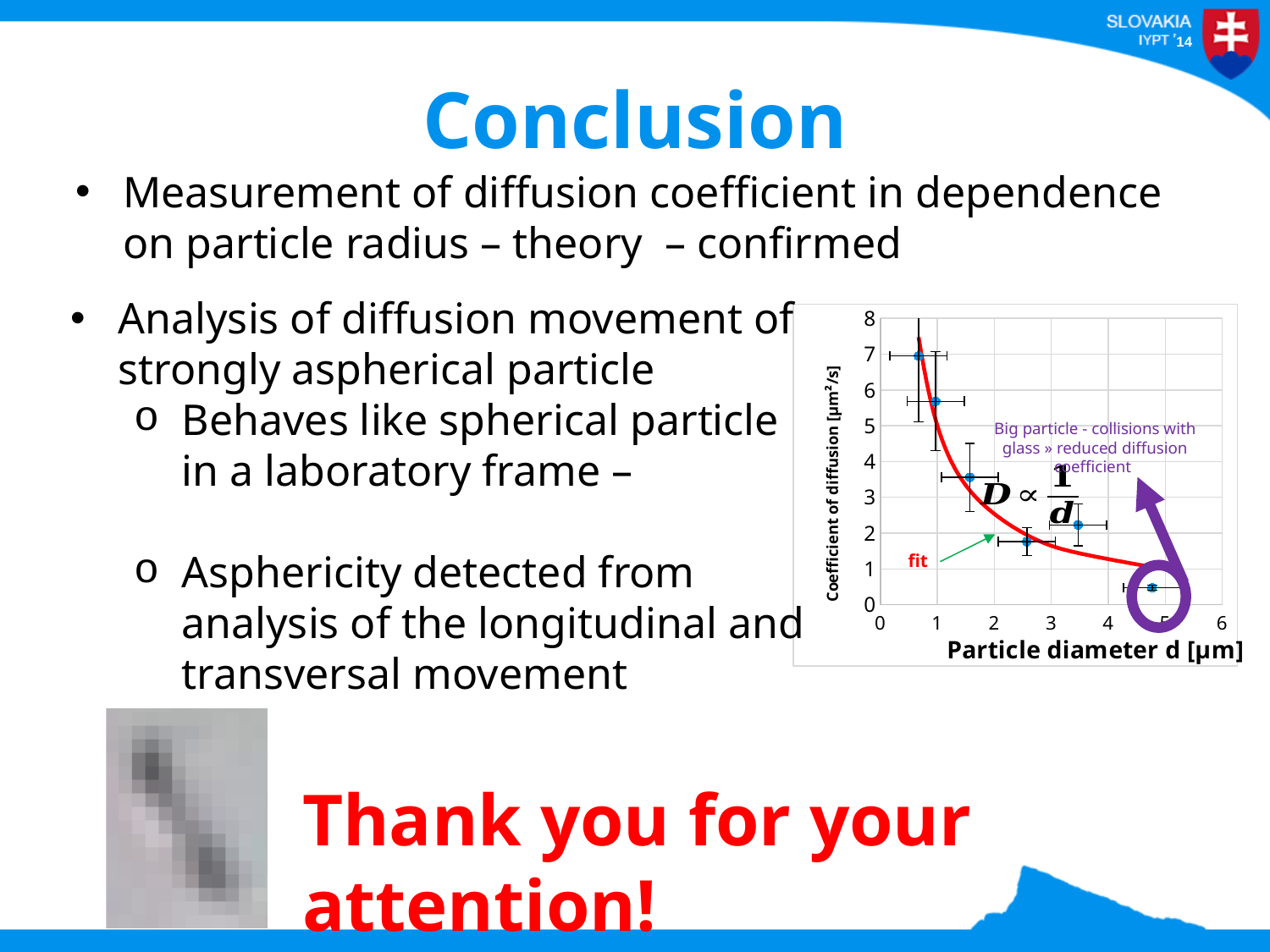
Is the coefficient of diffusion for the rightmost data point (near d = 5 μm) greater or less than 1? less Which data point has the lowest coefficient of diffusion: the leftmost point or the rightmost point? the rightmost point Is the coefficient of diffusion for the data point near d = 2.5 μm greater or less than 3? less What is the maximum value shown on the y axis of the chart? 8 Which has the larger coefficient of diffusion: the data point near d = 1 μm or the data point near d = 3.5 μm? the data point near d = 1 μm What is the label of the y axis of the chart? Coefficient of diffusion [μm²/s] What kind of chart is shown on the slide? scatter chart with a fit curve Which data point has the highest coefficient of diffusion: the leftmost point (smallest diameter) or the rightmost point (largest diameter)? the leftmost point How many data points are plotted in the chart? 6 What is the label of the x axis of the chart? Particle diameter d [μm] Does the coefficient of diffusion rise or fall as the particle diameter increases? fall Is the coefficient of diffusion for the leftmost data point greater or less than 6? greater